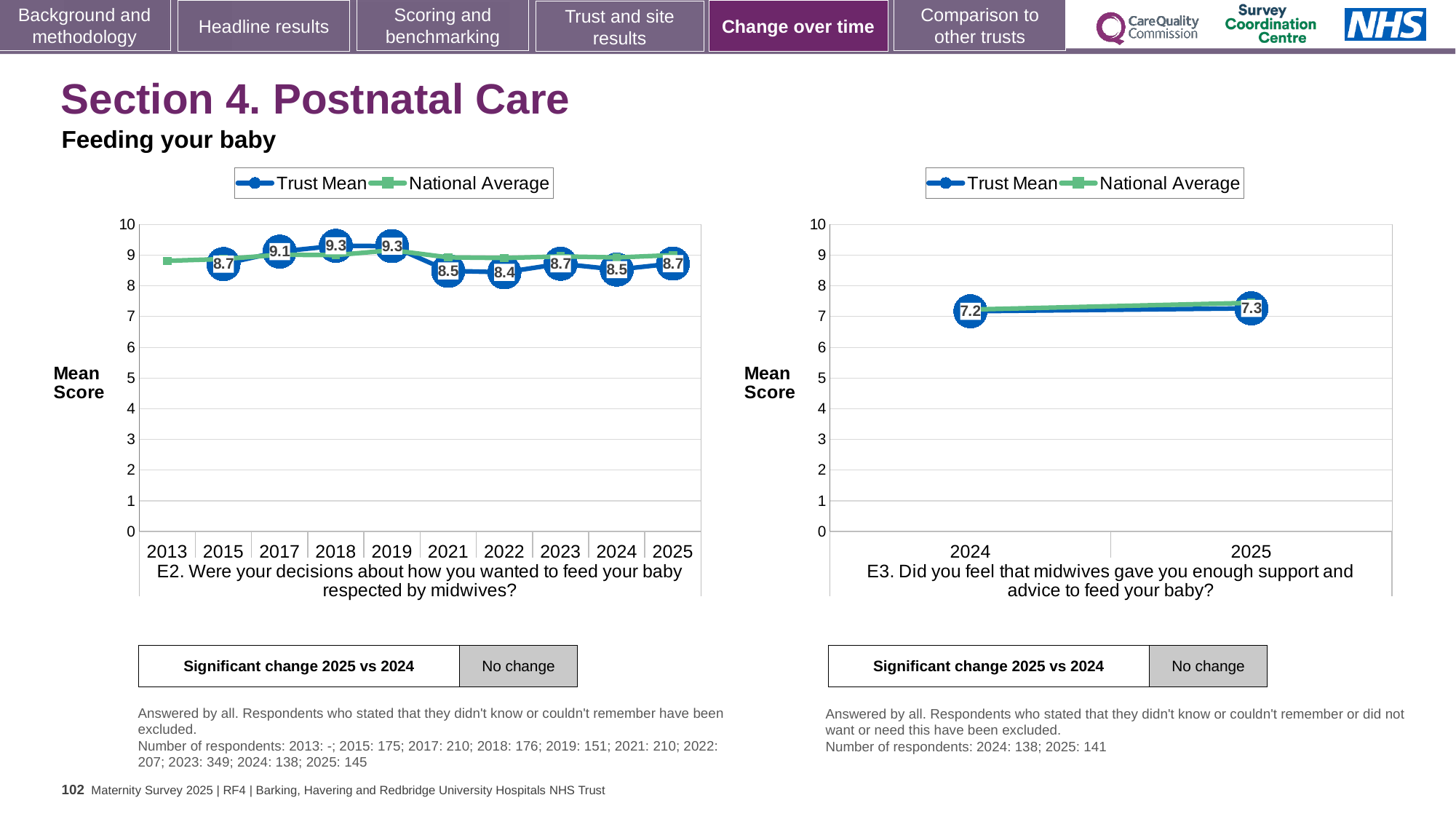
In the left chart (E2), which year has the lowest Trust Mean? 2022 What are the two series named in the legend of the left chart (E2)? Trust Mean and National Average In the left chart (E2), is the National Average for 2013 greater or less than 8? greater How many years are shown on the x axis of the left chart (E2)? 10 In the left chart (E2), is the Trust Mean higher in 2017 or in 2024? 2017 In the left chart (E2), what is the difference between the Trust Mean in 2019 and in 2025? 0.6 In the right chart (E3), what is the Trust Mean for 2025? 7.3 In the right chart (E3), does the Trust Mean rise or fall from 2024 to 2025? Rise What kind of chart is the right chart (E3)? Line chart In the left chart (E2), what is the Trust Mean for 2018? 9.3 How many series does the legend of the right chart (E3) list? 2 In the left chart (E2), what is the Trust Mean for 2022? 8.4